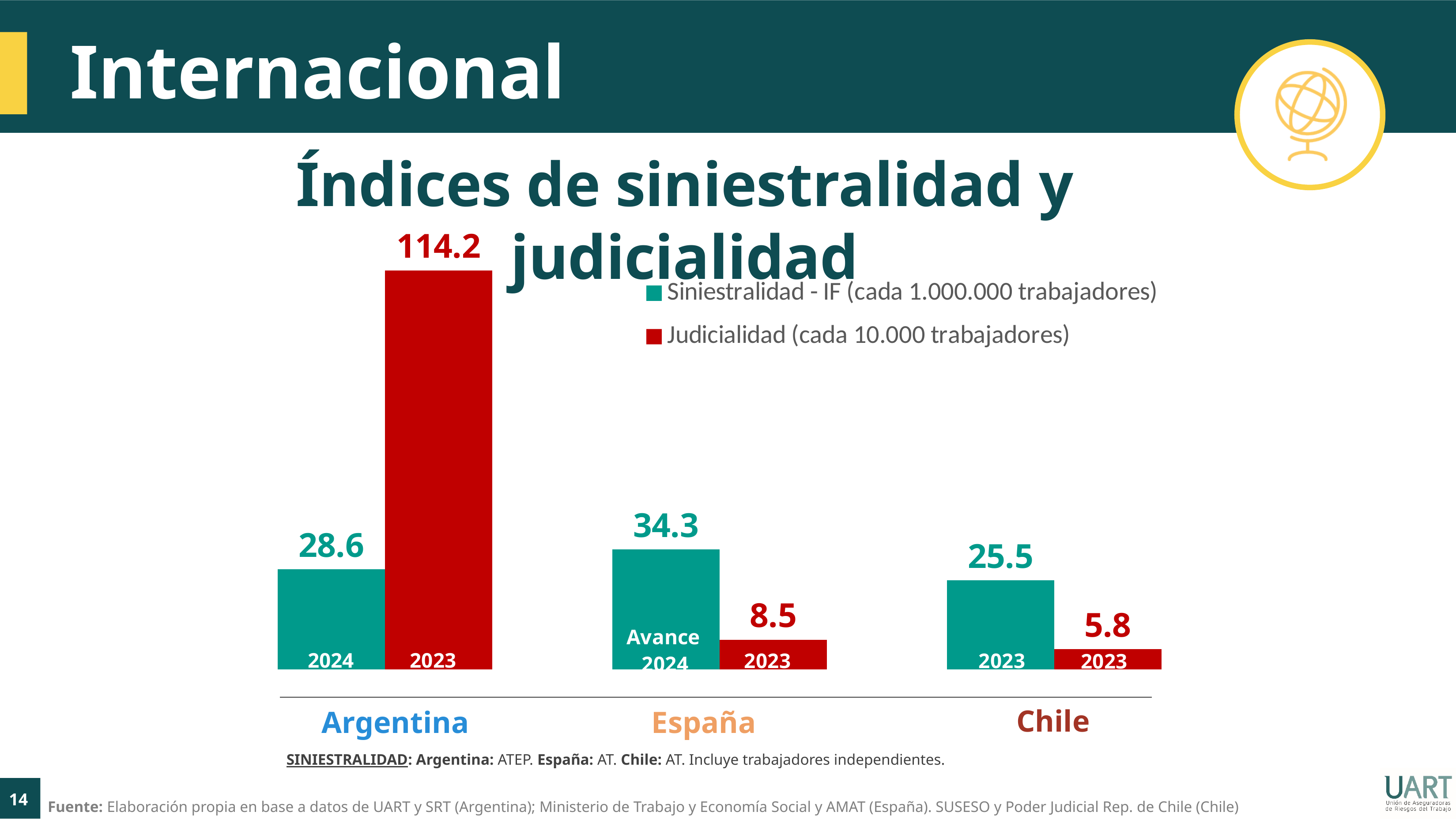
Which country has the lowest Siniestralidad - IF value? Chile What colour are the Judicialidad bars? Red Which is larger, the Siniestralidad - IF value for España or for Argentina? España What is the Siniestralidad - IF value for España? 34.3 How many series does the legend list? 2 What kind of chart is shown on the slide? Bar chart Which country has the highest Judicialidad value? Argentina What is the difference between the Judicialidad values for España and Chile? 2.7 What is the Judicialidad value for Argentina? 114.2 How many countries are shown on the x axis? 3 What is the Siniestralidad - IF value for Argentina? 28.6 What is the Judicialidad value for Chile? 5.8